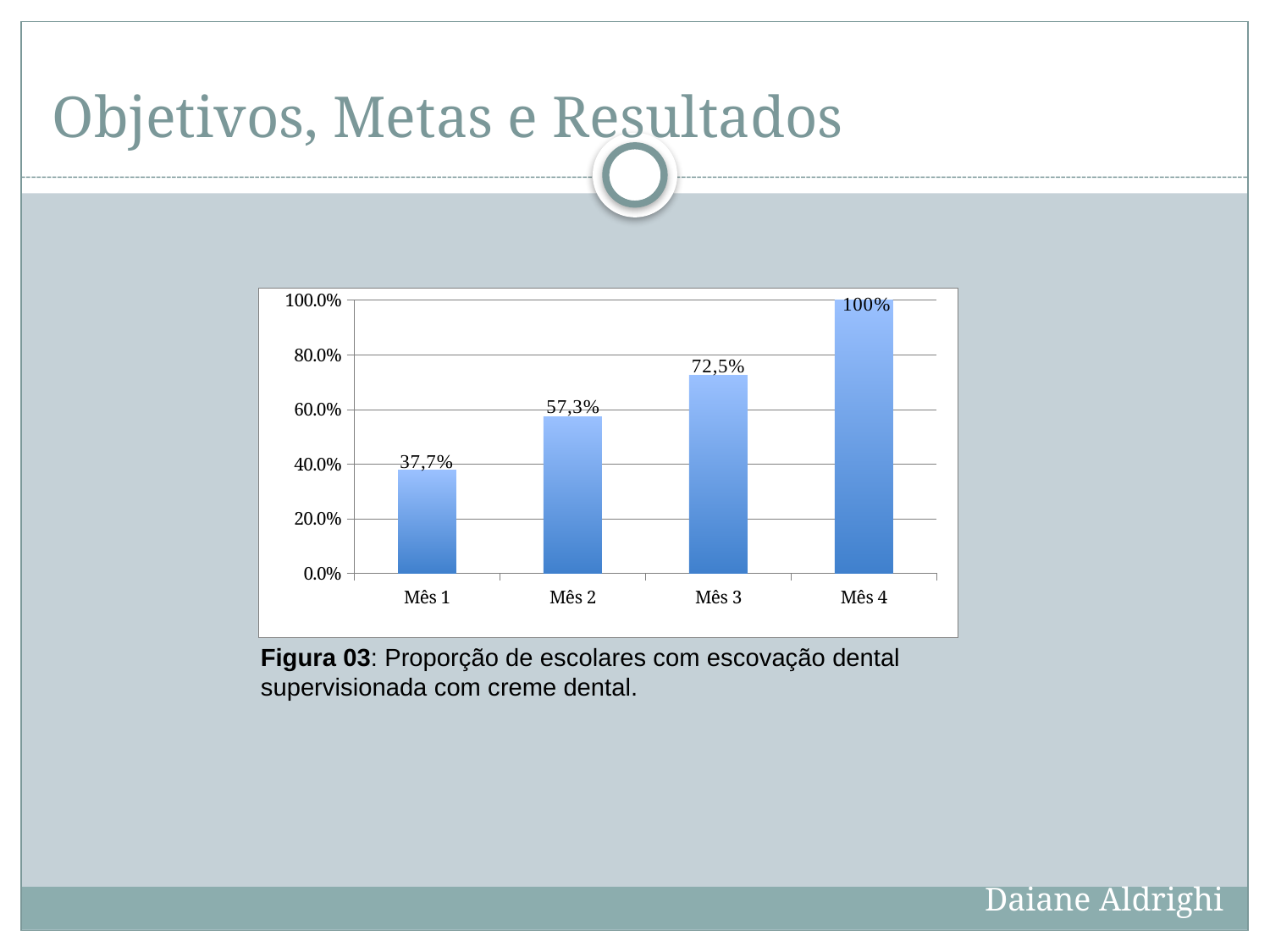
What kind of chart is shown on the slide? Bar chart What is the value for Mês 1? 37,7% What is the value for Mês 3? 72,5% Which month has the lowest value? Mês 1 What is the value for Mês 4? 100% How many categories are shown on the x axis? 4 Which is larger, the value for Mês 2 or the value for Mês 3? Mês 3 What is the value for Mês 2? 57,3% What is the difference between the values for Mês 4 and Mês 1? 62,3% Do the values rise or fall from Mês 1 to Mês 4? Rise What is the difference between the values for Mês 3 and Mês 2? 15,2% Which month has the highest value? Mês 4